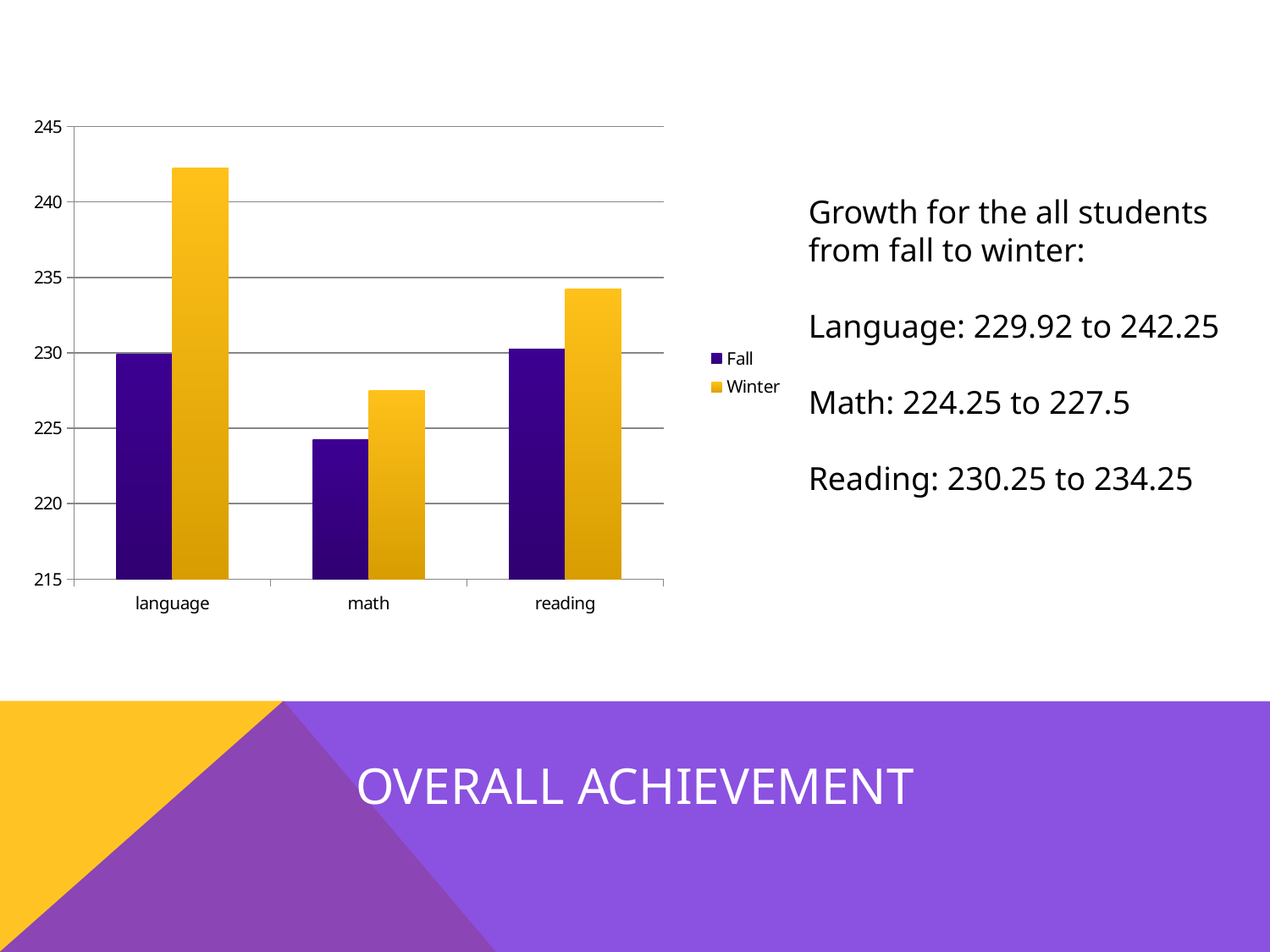
What is the Winter value for language? 242.25 What is the Winter value for reading? 234.25 How many categories are shown on the x axis of the chart? 3 What is the Fall value for math? 224.25 How many series does the chart's legend list? 2 Which category has the lowest Fall value? math Which series is shown in yellow in the chart? Winter What is the difference between the Winter and Fall values for math? 3.25 Which is larger, the Fall value for reading or the Fall value for language? Fall value for reading Is the Winter value for language greater or less than 240? greater What kind of chart is shown on the slide? bar chart Which category has the highest Winter value? language